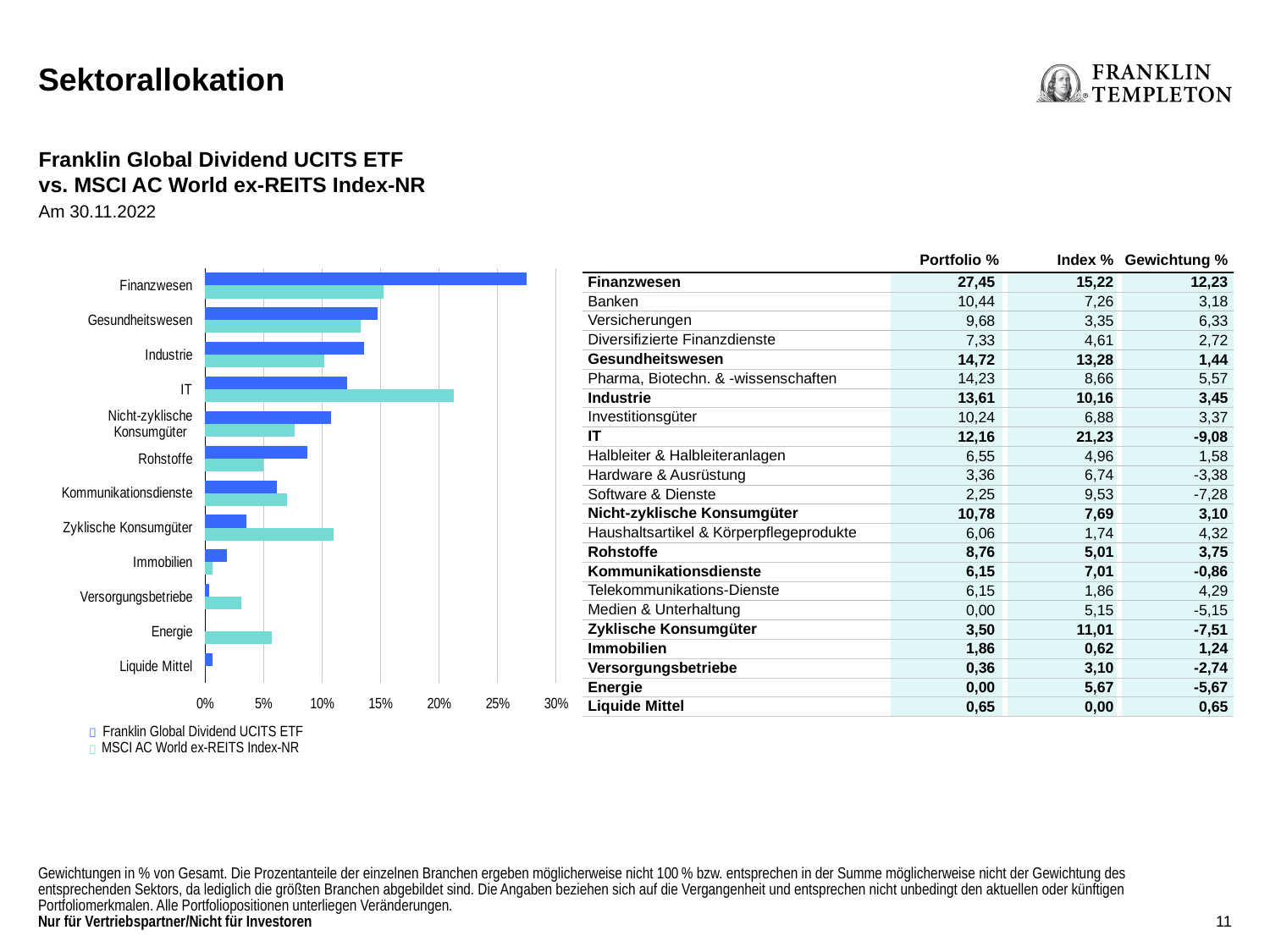
What are the two series named in the chart legend? Franklin Global Dividend UCITS ETF and MSCI AC World ex-REITS Index-NR What is the difference between the Portfolio % and Index % values for Finanzwesen? 12,23 What kind of chart is shown on the slide? bar chart How many series does the chart legend list? 2 Is the Franklin Global Dividend UCITS ETF value for Finanzwesen greater or less than 25%? greater Which sector has the highest Franklin Global Dividend UCITS ETF bar? Finanzwesen Which sector has the lowest MSCI AC World ex-REITS Index-NR value? Liquide Mittel Is the MSCI AC World ex-REITS Index-NR value for IT greater or less than 20%? greater What is the Portfolio % value for Rohstoffe? 8,76 Is the MSCI AC World ex-REITS Index-NR value for Zyklische Konsumgüter greater or less than 10%? greater How many sector categories are plotted on the chart? 12 For IT, which is larger: the Franklin Global Dividend UCITS ETF bar or the MSCI AC World ex-REITS Index-NR bar? MSCI AC World ex-REITS Index-NR